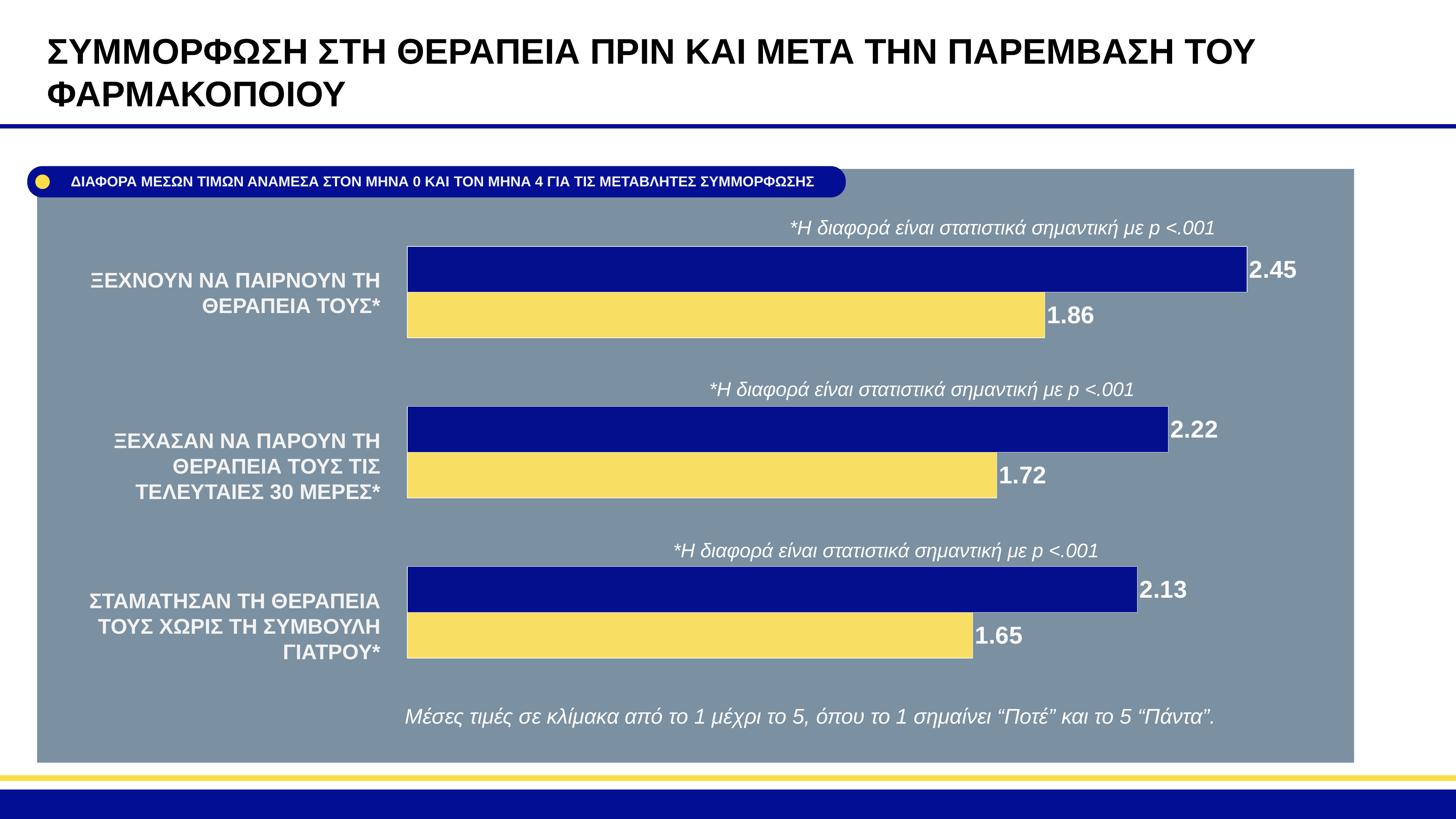
What is the value of the dark blue bar for "ΞΕΧΝΟΥΝ ΝΑ ΠΑΙΡΝΟΥΝ ΤΗ ΘΕΡΑΠΕΙΑ ΤΟΥΣ*"? 2.45 What type of chart is shown on the slide? Bar chart What is the value of the dark blue bar for "ΞΕΧΑΣΑΝ ΝΑ ΠΑΡΟΥΝ ΤΗ ΘΕΡΑΠΕΙΑ ΤΟΥΣ ΤΙΣ ΤΕΛΕΥΤΑΙΕΣ 30 ΜΕΡΕΣ*"? 2.22 Which is larger: the dark blue bar for "ΣΤΑΜΑΤΗΣΑΝ ΤΗ ΘΕΡΑΠΕΙΑ ΤΟΥΣ ΧΩΡΙΣ ΤΗ ΣΥΜΒΟΥΛΗ ΓΙΑΤΡΟΥ*" or the yellow bar for "ΞΕΧΝΟΥΝ ΝΑ ΠΑΙΡΝΟΥΝ ΤΗ ΘΕΡΑΠΕΙΑ ΤΟΥΣ*"? The dark blue bar for ΣΤΑΜΑΤΗΣΑΝ ΤΗ ΘΕΡΑΠΕΙΑ ΤΟΥΣ ΧΩΡΙΣ ΤΗ ΣΥΜΒΟΥΛΗ ΓΙΑΤΡΟΥ* (2.13) How many categories are shown in the chart? 3 What is the value of the yellow bar for "ΞΕΧΝΟΥΝ ΝΑ ΠΑΙΡΝΟΥΝ ΤΗ ΘΕΡΑΠΕΙΑ ΤΟΥΣ*"? 1.86 What is the title of the chart? ΔΙΑΦΟΡΑ ΜΕΣΩΝ ΤΙΜΩΝ ΑΝΑΜΕΣΑ ΣΤΟΝ ΜΗΝΑ 0 ΚΑΙ ΤΟΝ ΜΗΝΑ 4 ΓΙΑ ΤΙΣ ΜΕΤΑΒΛΗΤΕΣ ΣΥΜΜΟΡΦΩΣΗΣ What is the difference between the dark blue and yellow bar values for "ΞΕΧΝΟΥΝ ΝΑ ΠΑΙΡΝΟΥΝ ΤΗ ΘΕΡΑΠΕΙΑ ΤΟΥΣ*"? 0.59 Which category has the highest dark blue bar value? ΞΕΧΝΟΥΝ ΝΑ ΠΑΙΡΝΟΥΝ ΤΗ ΘΕΡΑΠΕΙΑ ΤΟΥΣ* What is the difference between the dark blue and yellow bar values for "ΞΕΧΑΣΑΝ ΝΑ ΠΑΡΟΥΝ ΤΗ ΘΕΡΑΠΕΙΑ ΤΟΥΣ ΤΙΣ ΤΕΛΕΥΤΑΙΕΣ 30 ΜΕΡΕΣ*"? 0.50 Which category has the lowest yellow bar value? ΣΤΑΜΑΤΗΣΑΝ ΤΗ ΘΕΡΑΠΕΙΑ ΤΟΥΣ ΧΩΡΙΣ ΤΗ ΣΥΜΒΟΥΛΗ ΓΙΑΤΡΟΥ* What is the value of the yellow bar for "ΣΤΑΜΑΤΗΣΑΝ ΤΗ ΘΕΡΑΠΕΙΑ ΤΟΥΣ ΧΩΡΙΣ ΤΗ ΣΥΜΒΟΥΛΗ ΓΙΑΤΡΟΥ*"? 1.65